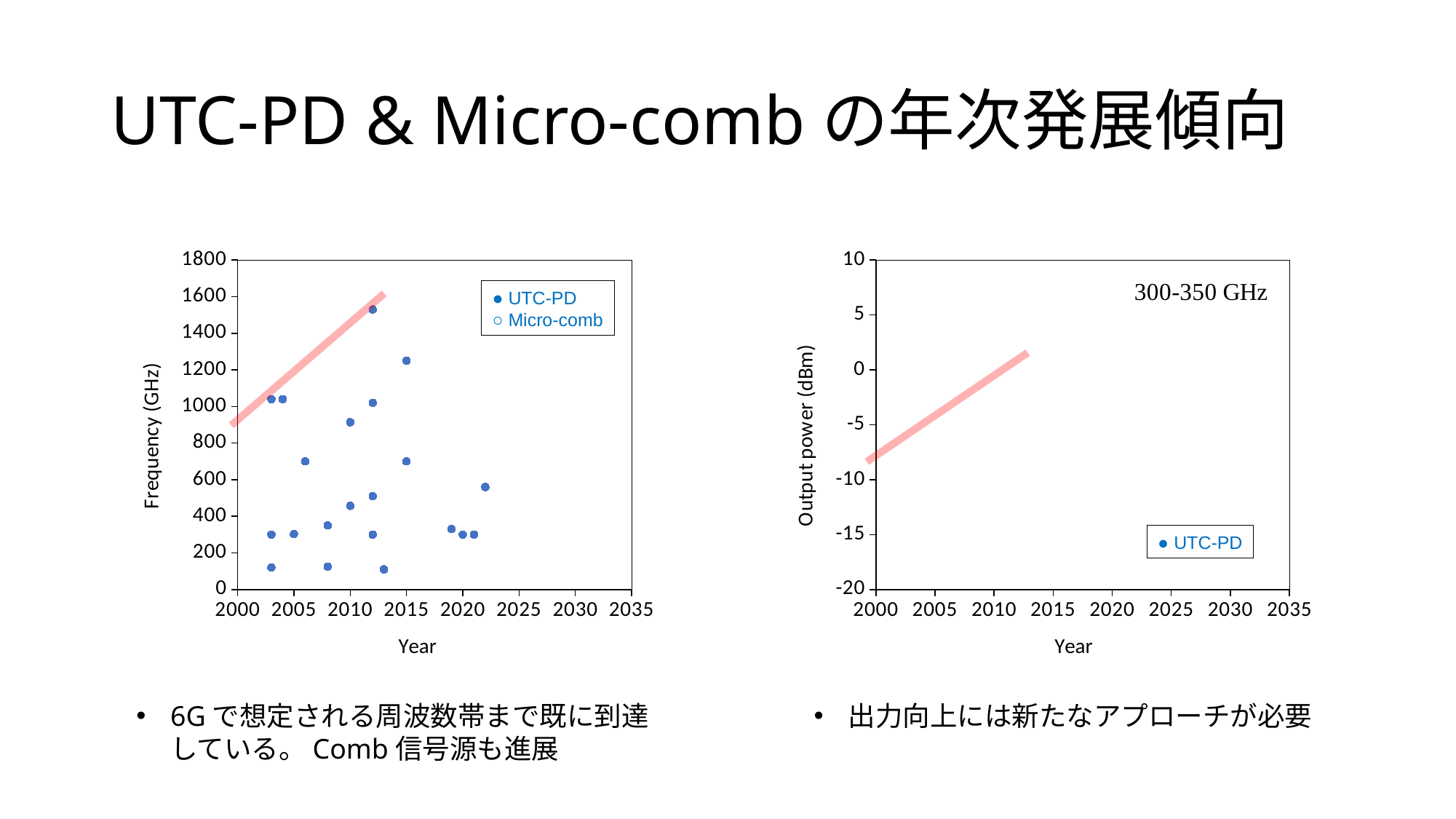
What is the y-axis label of the right chart? Output power (dBm) In the left chart (Frequency vs Year), does the pink trend line rise or fall as the year increases? rise In the right chart (Output power vs Year), does the pink trend line rise or fall as the year increases? rise In the left chart (Frequency vs Year), in which year does the highest-frequency UTC-PD point appear? 2012 How many series does the legend of the left chart (Frequency vs Year) list? 2 In the left chart (Frequency vs Year), is the lowest UTC-PD point greater or less than 200 GHz? less In the left chart (Frequency vs Year), is the highest UTC-PD point greater or less than 1400 GHz? greater In the left chart (Frequency vs Year), is the UTC-PD point at 2022 greater or less than 400 GHz? greater In the left chart (Frequency vs Year), which series is shown with filled markers, UTC-PD or Micro-comb? UTC-PD What kind of chart is the left chart (Frequency vs Year)? scatter chart How many series does the legend of the right chart (Output power vs Year) list? 1 What frequency range is annotated on the right chart (Output power vs Year)? 300-350 GHz